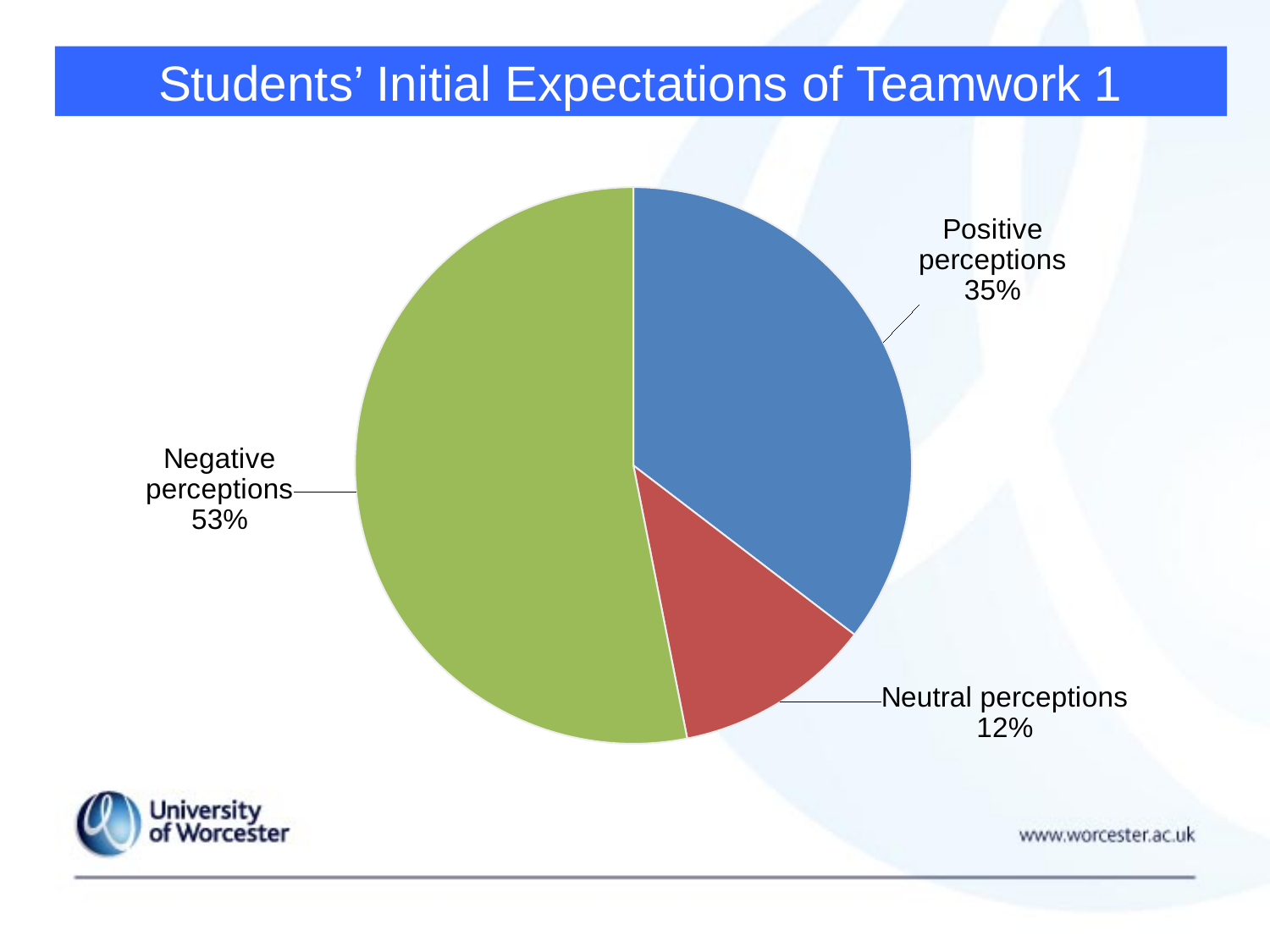
Which is larger, the share for positive perceptions or the share for neutral perceptions? Positive perceptions What colour is the slice for negative perceptions? Green What is the difference in percentage points between negative perceptions and positive perceptions? 18 How many slices does the pie chart have? 3 What is the difference in percentage points between positive perceptions and neutral perceptions? 23 What is the title of the slide containing the chart? Students' Initial Expectations of Teamwork 1 What percentage of students had negative perceptions? 53% What percentage of students had neutral perceptions? 12% Which category has the largest share of the pie? Negative perceptions What kind of chart is shown on the slide? Pie chart Which category has the smallest share of the pie? Neutral perceptions What percentage of students had positive perceptions? 35%